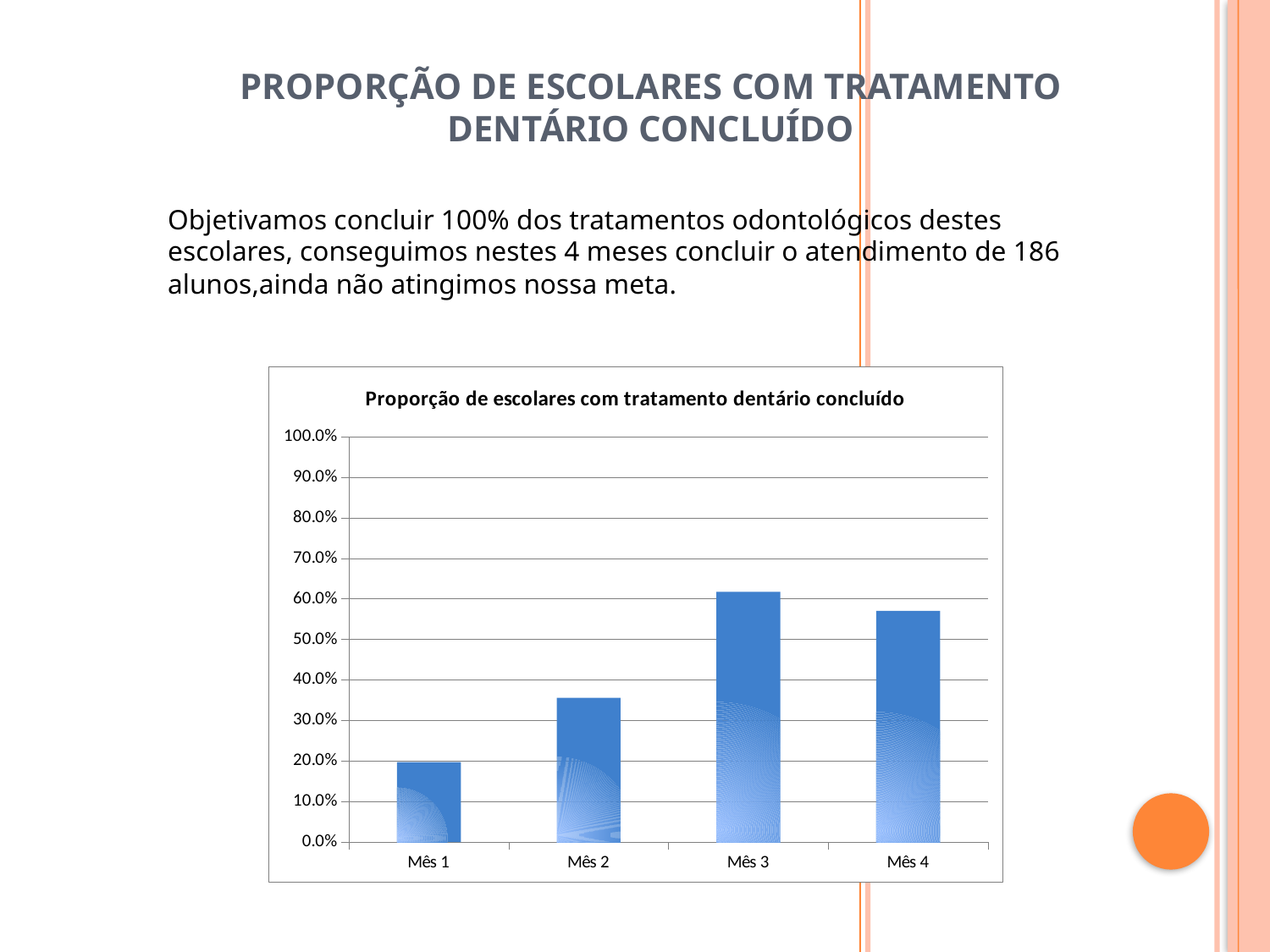
What is the title of the chart? Proporção de escolares com tratamento dentário concluído Which is larger, the value for Mês 1 or the value for Mês 2? Mês 2 Which month has the lowest proportion of students with completed dental treatment? Mês 1 Is the value for Mês 4 greater or less than 60.0%? less Is the value for Mês 2 greater or less than 30.0%? greater What kind of chart is shown on the slide? bar chart How many categories (months) are shown on the x axis of the chart? 4 Is the value for Mês 3 greater or less than 60.0%? greater Do the values rise or fall from Mês 1 to Mês 3? rise Which is larger, the value for Mês 3 or the value for Mês 4? Mês 3 Which month has the highest proportion of students with completed dental treatment? Mês 3